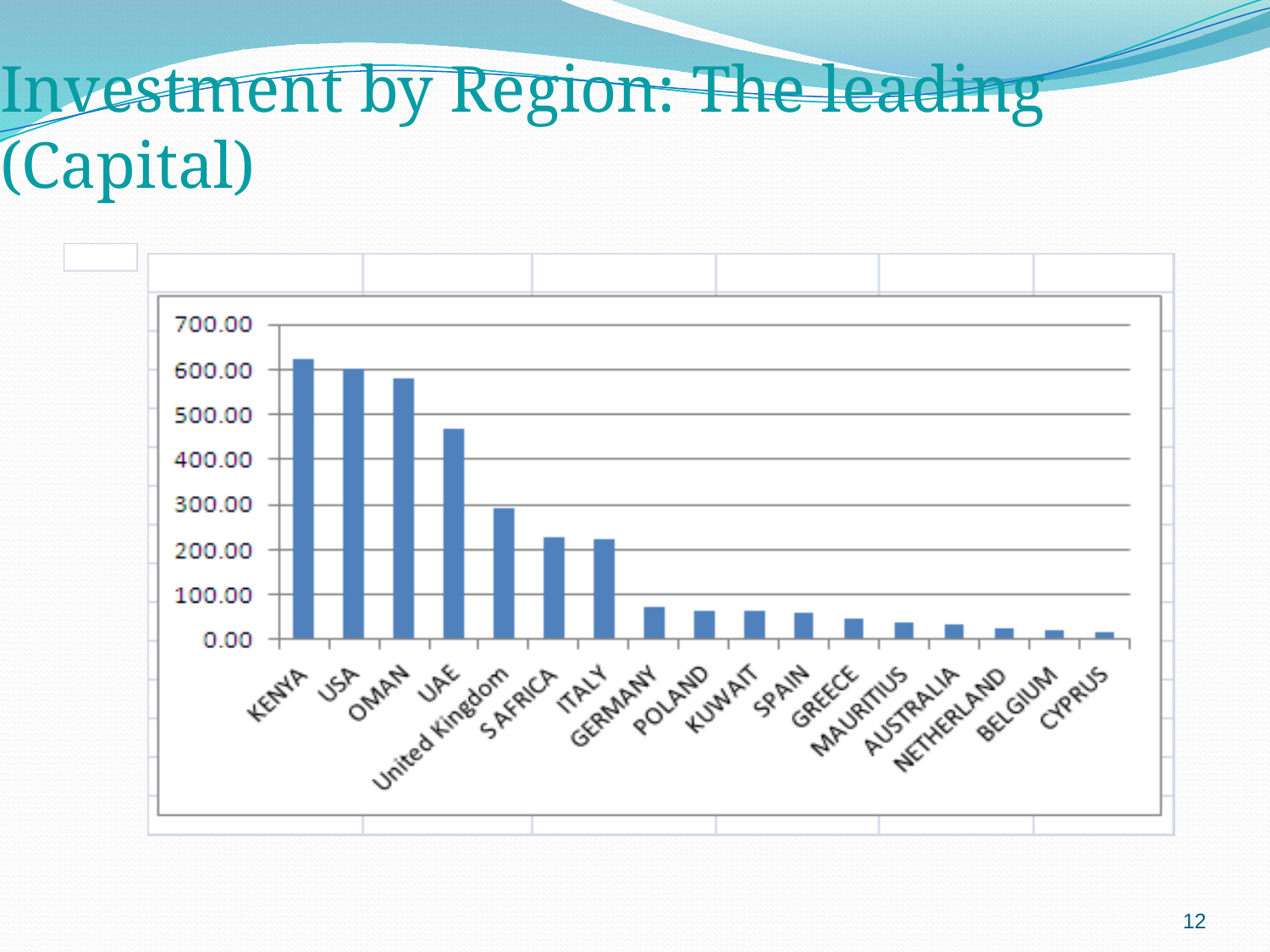
Which country has the highest bar in the chart? KENYA What is the title of the slide containing the chart? Investment by Region: The leading (Capital) Is the value for KENYA greater or less than 600.00? greater Which has a larger value, United Kingdom or GERMANY? United Kingdom Which country has the lowest bar in the chart? CYPRUS What kind of chart is shown on the slide? bar chart Do the bar values rise or fall moving from left to right along the x axis? fall How many countries are shown on the x axis of the chart? 17 Is the value for UAE greater or less than 500.00? less Is the value for OMAN greater or less than 500.00? greater Which has a larger value, UAE or ITALY? UAE